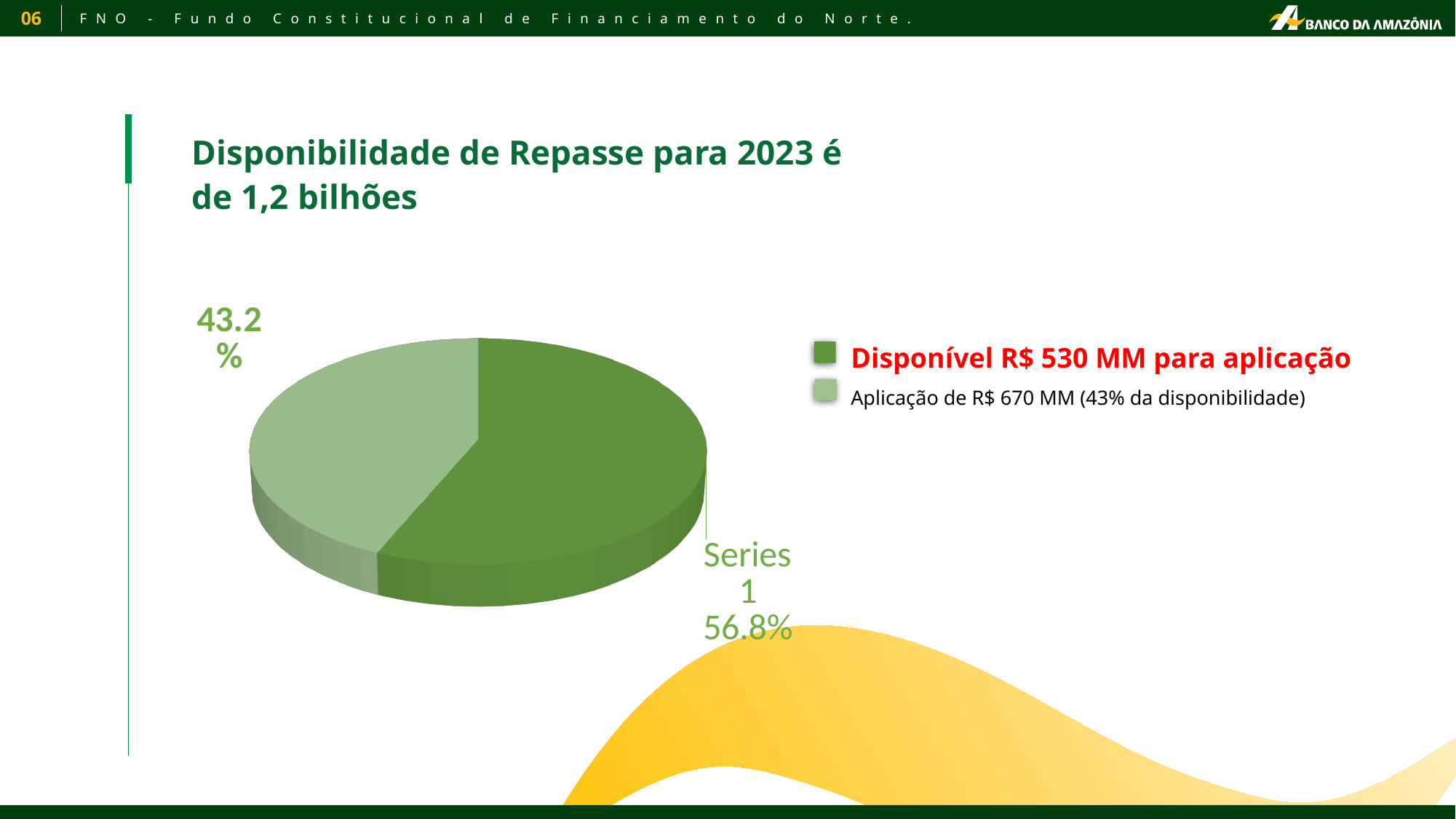
According to the legend, what amount is given for 'Aplicação'? R$ 670 MM What percentage is shown for the dark green slice of the pie chart? 56.8% According to the legend, what does the dark green colour represent? Disponível R$ 530 MM para aplicação What percentage is shown for the light green slice of the pie chart? 43.2% Is the dark green slice larger or smaller than the light green slice? Larger How many slices does the pie chart have? 2 What is the difference in percentage points between the dark green slice and the light green slice? 13.6 percentage points Is the light green slice's share greater or less than 50%? Less What is the title above the pie chart? Disponibilidade de Repasse para 2023 é de 1,2 bilhões Which slice of the pie chart is the largest? The dark green slice (56.8%) What kind of chart is shown on the slide? Pie chart Which slice of the pie chart is the smallest? The light green slice (43.2%)